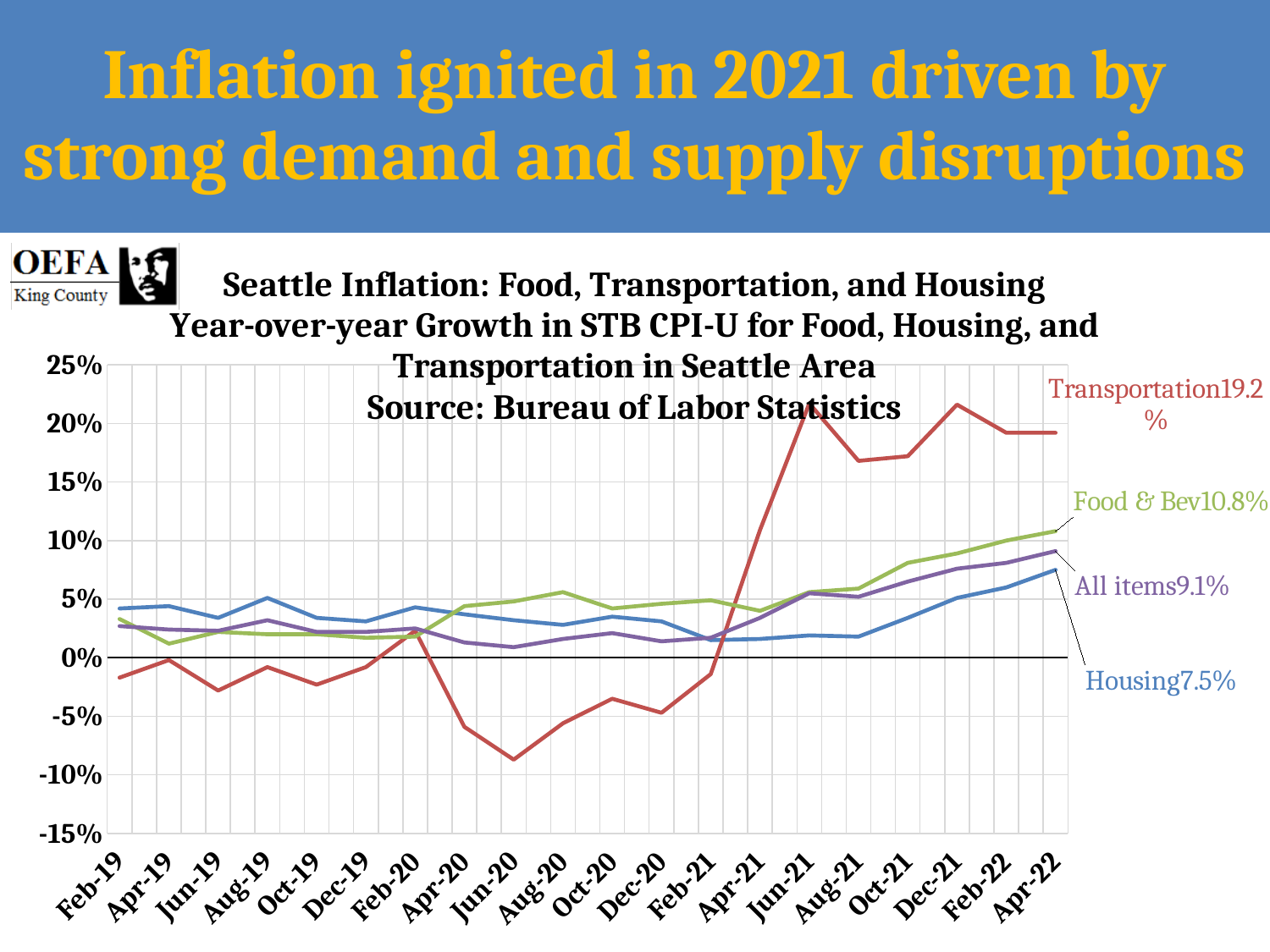
What is the Housing value labeled at the end of the line (Apr-22)? 7.5% Which series has the highest labeled value at Apr-22? Transportation What is the All items value labeled at the end of the line (Apr-22)? 9.1% How many series are plotted on the chart? 4 At Apr-22, which is larger: Food & Bev or All items? Food & Bev What kind of chart is shown on the slide? Line chart What is the difference between the Transportation and Housing values labeled at Apr-22? 11.7 percentage points What is the Transportation value labeled at the end of the line (Apr-22)? 19.2% Which series has the lowest labeled value at Apr-22? Housing Does the Housing line rise or fall from Feb-21 to Apr-22? Rises What is the Food & Bev value labeled at the end of the line (Apr-22)? 10.8% Is the Transportation value in Jun-20 greater or less than -5%? less